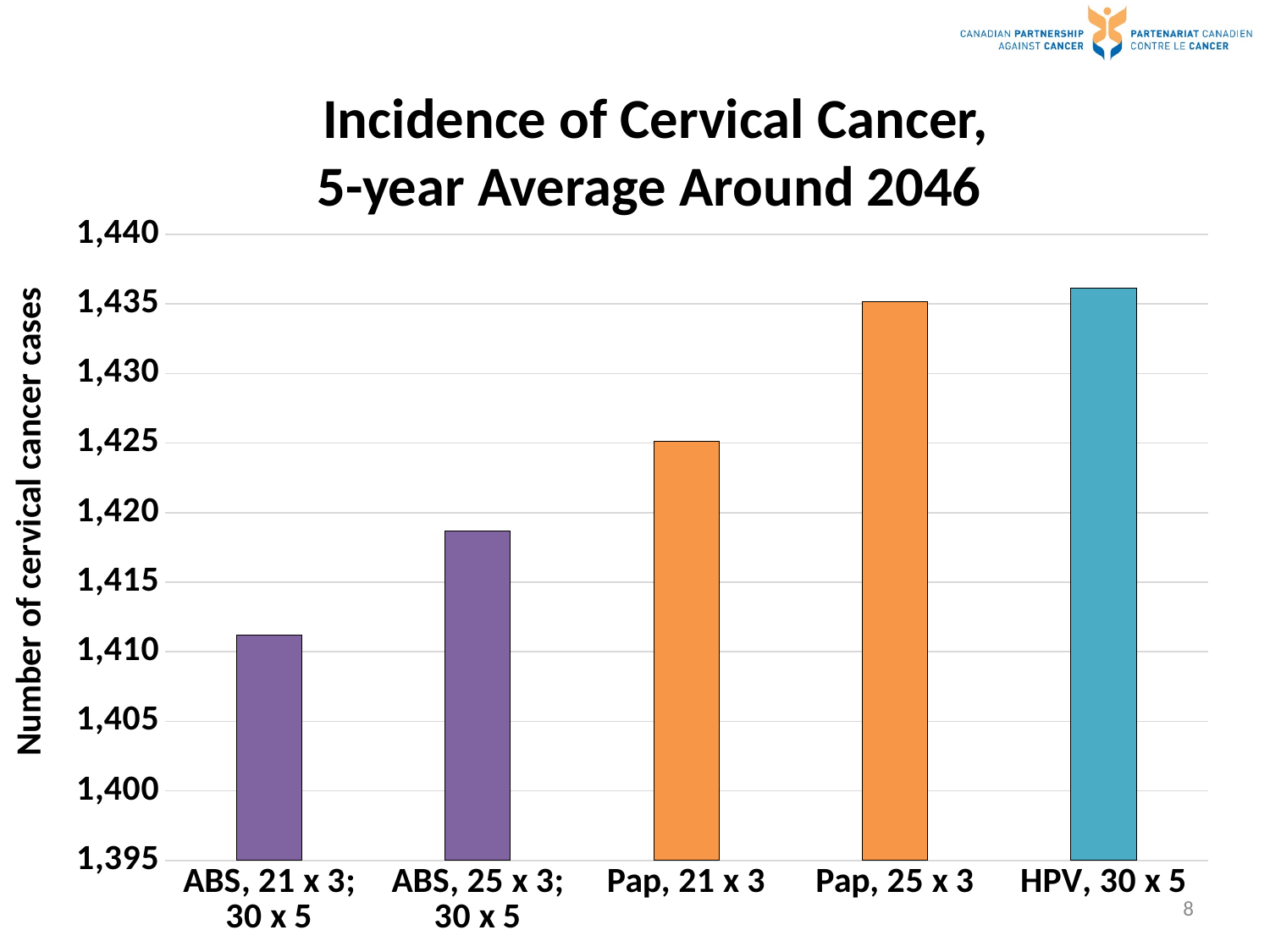
Is the value for ABS, 25 x 3; 30 x 5 greater or less than 1,415? greater Is the value for Pap, 21 x 3 greater or less than 1,420? greater Which category has the lowest number of cervical cancer cases? ABS, 21 x 3; 30 x 5 Which is larger, the value for Pap, 21 x 3 or the value for ABS, 25 x 3; 30 x 5? Pap, 21 x 3 What is the label on the vertical axis of the chart? Number of cervical cancer cases Is the value for HPV, 30 x 5 greater or less than 1,430? greater Which is larger, the value for Pap, 25 x 3 or the value for Pap, 21 x 3? Pap, 25 x 3 Do the values rise or fall moving from left to right across the categories? rise What kind of chart is shown on the slide? bar chart How many bars (categories) are plotted in the chart? 5